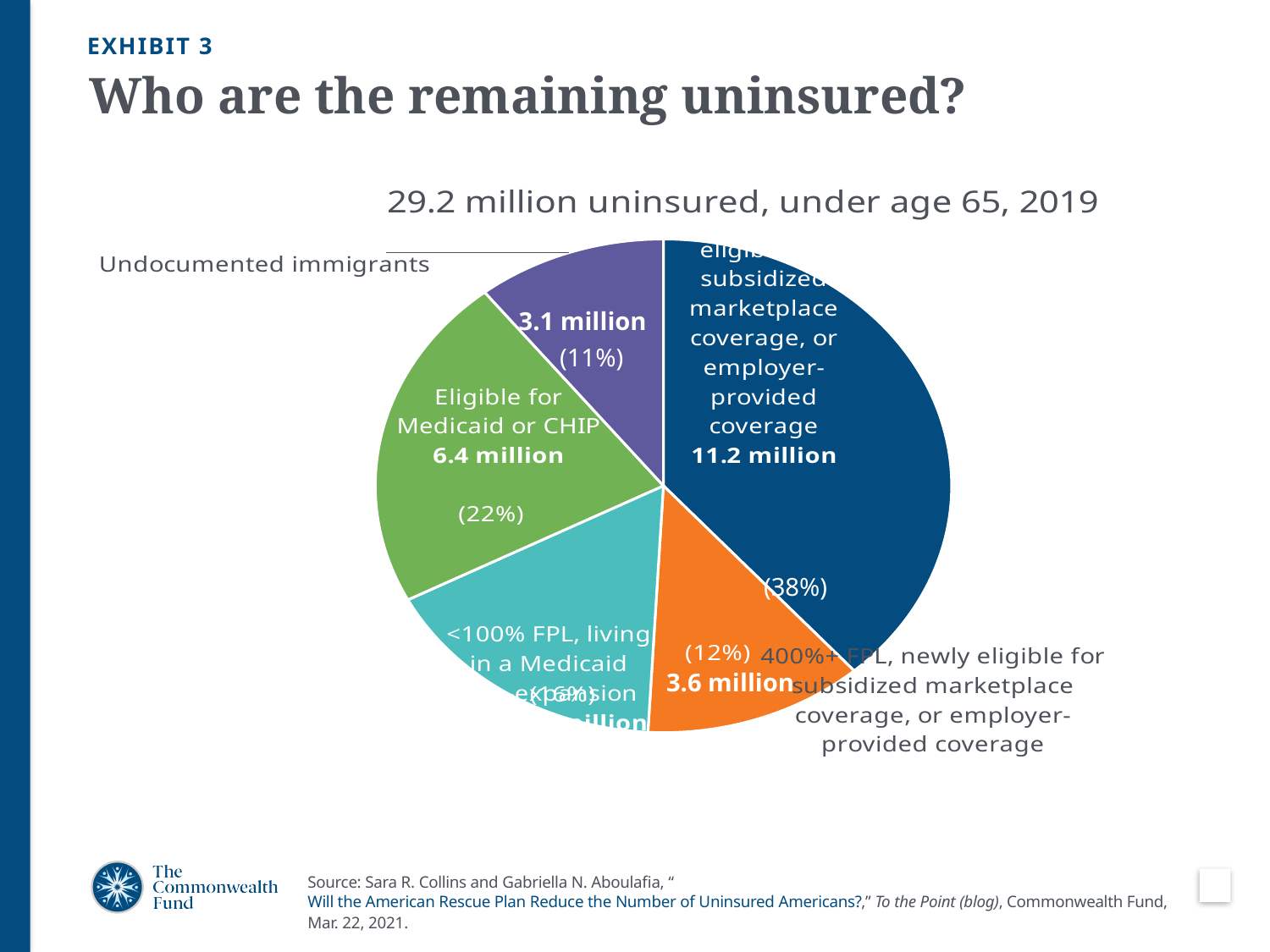
What share of the pie do undocumented immigrants represent? 11% What is the value of the largest slice in the pie chart? 11.2 million How many uninsured people are undocumented immigrants according to the pie chart? 3.1 million What kind of chart is shown on the slide? pie chart Which is larger: the 'Eligible for Medicaid or CHIP' slice or the '400%+ FPL' slice? Eligible for Medicaid or CHIP How many uninsured people are eligible for Medicaid or CHIP? 6.4 million What is the value for the '400%+ FPL, newly eligible for subsidized marketplace coverage, or employer-provided coverage' slice? 3.6 million How much larger is the 'Eligible for Medicaid or CHIP' group than the 'Undocumented immigrants' group? 3.3 million What share of the pie is the '400%+ FPL' slice? 12% What share of the pie is the 'Eligible for Medicaid or CHIP' slice? 22% How many slices does the pie chart have? 5